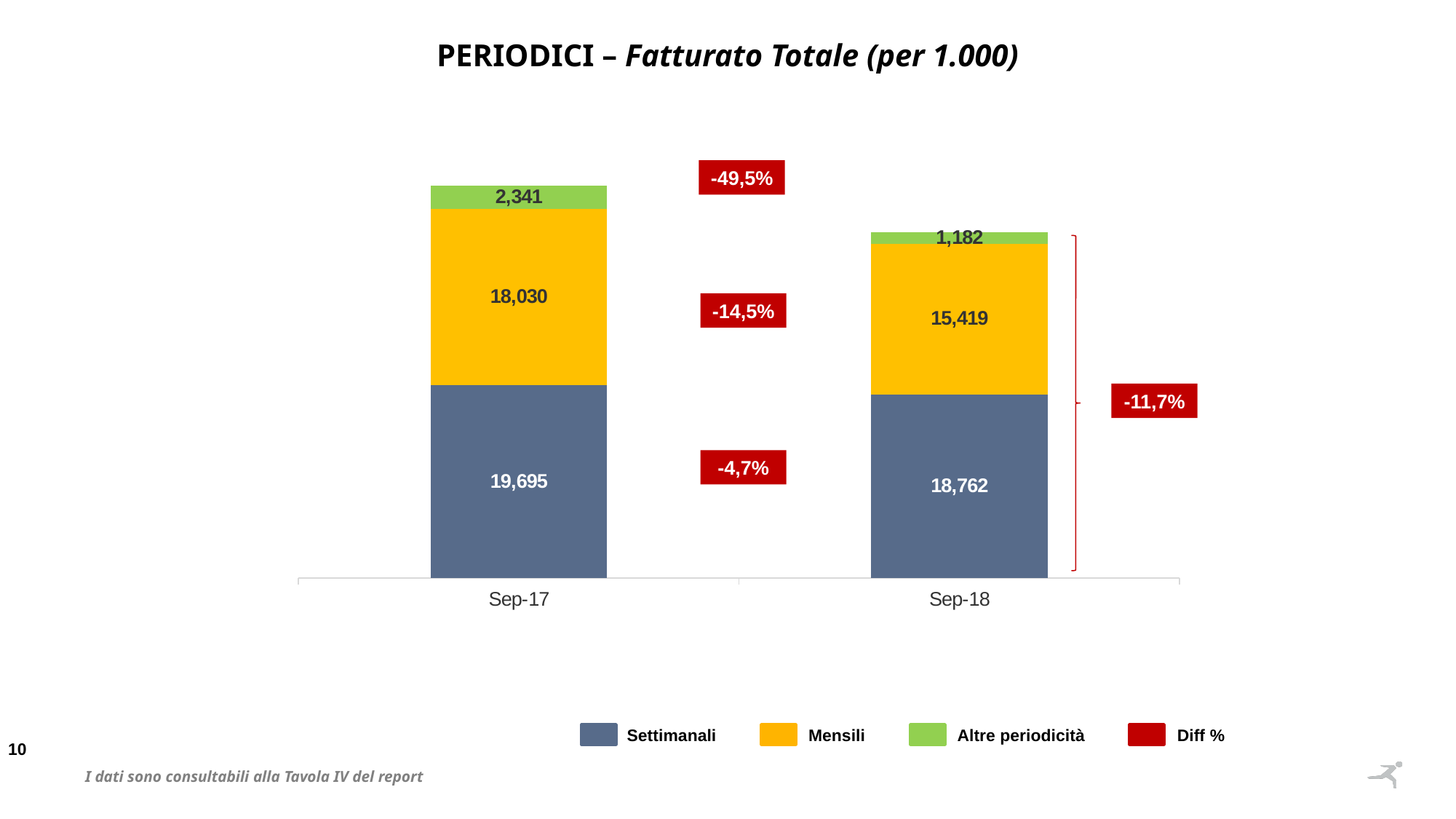
Which is larger, Settimanali in Sep-17 or Settimanali in Sep-18? Sep-17 What is the total of the stacked bar for Sep-18? 35,363 How many categories are shown on the x axis? 2 What is the difference between the Mensili values for Sep-17 and Sep-18? 2,611 What is the value for Altre periodicità in Sep-17? 2,341 What is the total of the stacked bar for Sep-17? 40,066 What is the value for Mensili in Sep-18? 15,419 How many series does the legend list? 4 What kind of chart is shown on the slide? Stacked bar chart What is the overall percentage change shown for the total between Sep-17 and Sep-18? -11,7% What percentage change is shown for Altre periodicità between Sep-17 and Sep-18? -49,5% What is the value for Settimanali in Sep-17? 19,695